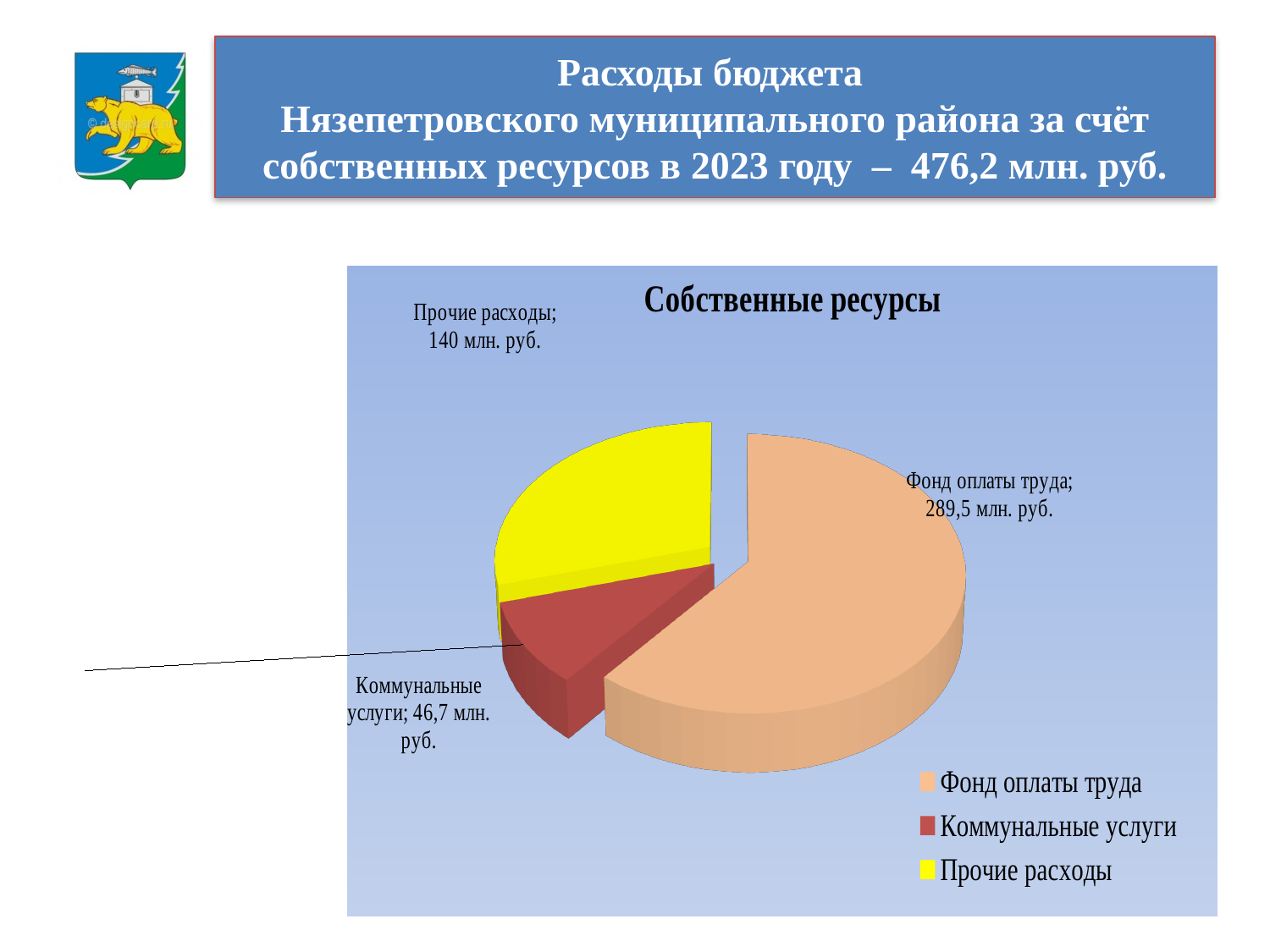
Which category has the smallest slice? Коммунальные услуги How many entries does the legend list? 3 What is the value for Коммунальные услуги? 46,7 млн. руб. What is the value for Фонд оплаты труда? 289,5 млн. руб. What is the value for Прочие расходы? 140 млн. руб. How many slices does the pie chart have? 3 Which is larger, Прочие расходы or Коммунальные услуги? Прочие расходы What colour is the slice for Прочие расходы? yellow Which category has the largest slice? Фонд оплаты труда What type of chart is shown on the slide? pie chart What is the title of the chart? Собственные ресурсы What is the difference between Фонд оплаты труда and Прочие расходы? 149,5 млн. руб.